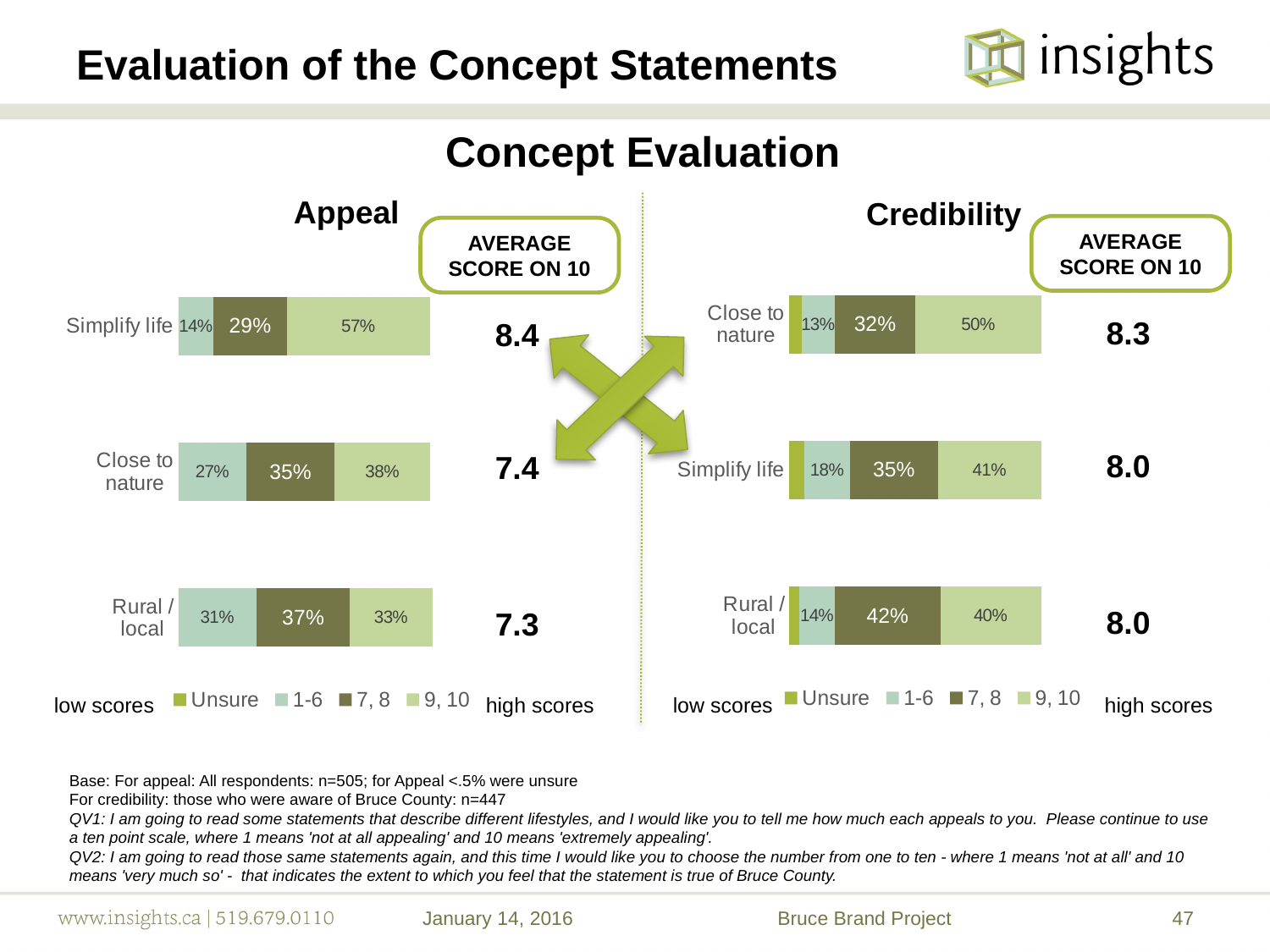
In the Credibility chart, what percentage gave 'Close to nature' a score of 9 or 10? 50% What type of chart is the Appeal chart? Stacked bar chart In the Appeal chart, which statement has the highest average score on 10? Simplify life In the Credibility chart, what percentage gave 'Rural / local' a score of 7 or 8? 42% How many statements are shown in the Appeal chart? 3 In the Credibility chart, which has a larger 1-6 percentage: 'Simplify life' or 'Close to nature'? Simplify life In the Appeal chart, what percentage gave 'Simplify life' a score of 9 or 10? 57% How many series does the legend of the Credibility chart list? 4 In the Credibility chart, which statement has the highest average score on 10? Close to nature In the Appeal chart, what is the difference between the 9, 10 percentages for 'Simplify life' and 'Rural / local'? 24 percentage points In the Appeal chart, what percentage gave 'Rural / local' a score of 1-6? 31% What is the average score on 10 for 'Close to nature' in the Appeal chart? 7.4